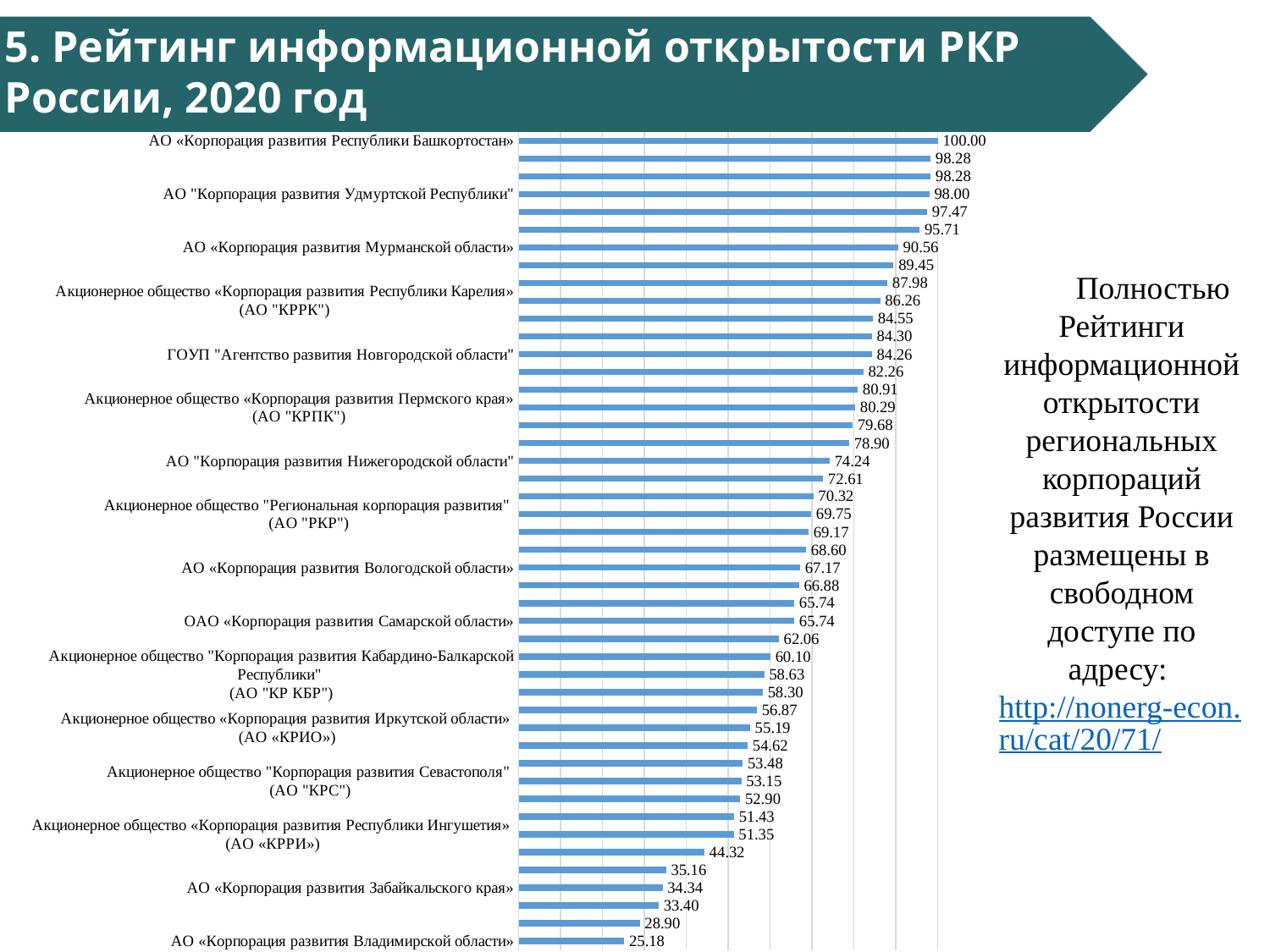
What is the value for АО «Корпорация развития Мурманской области»? 90.56 What kind of chart is shown on the slide? Bar chart What is the value for АО «Корпорация развития Владимирской области»? 25.18 What is the title of the slide? 5. Рейтинг информационной открытости РКР России, 2020 год Which organisation has the lowest value in the chart? АО «Корпорация развития Владимирской области» What is the value for АО "Корпорация развития Удмуртской Республики"? 98.00 Do the values rise or fall going from the top of the chart to the bottom? Fall Which has a larger value: АО «Корпорация развития Мурманской области» or АО «Корпорация развития Вологодской области»? АО «Корпорация развития Мурманской области» What is the difference between the values for АО «Корпорация развития Республики Башкортостан» and АО «Корпорация развития Владимирской области»? 74.82 What is the value for АО «Корпорация развития Республики Башкортостан»? 100.00 Which organisation has the highest value in the chart? АО «Корпорация развития Республики Башкортостан» What is the value for АО «Корпорация развития Забайкальского края»? 34.34